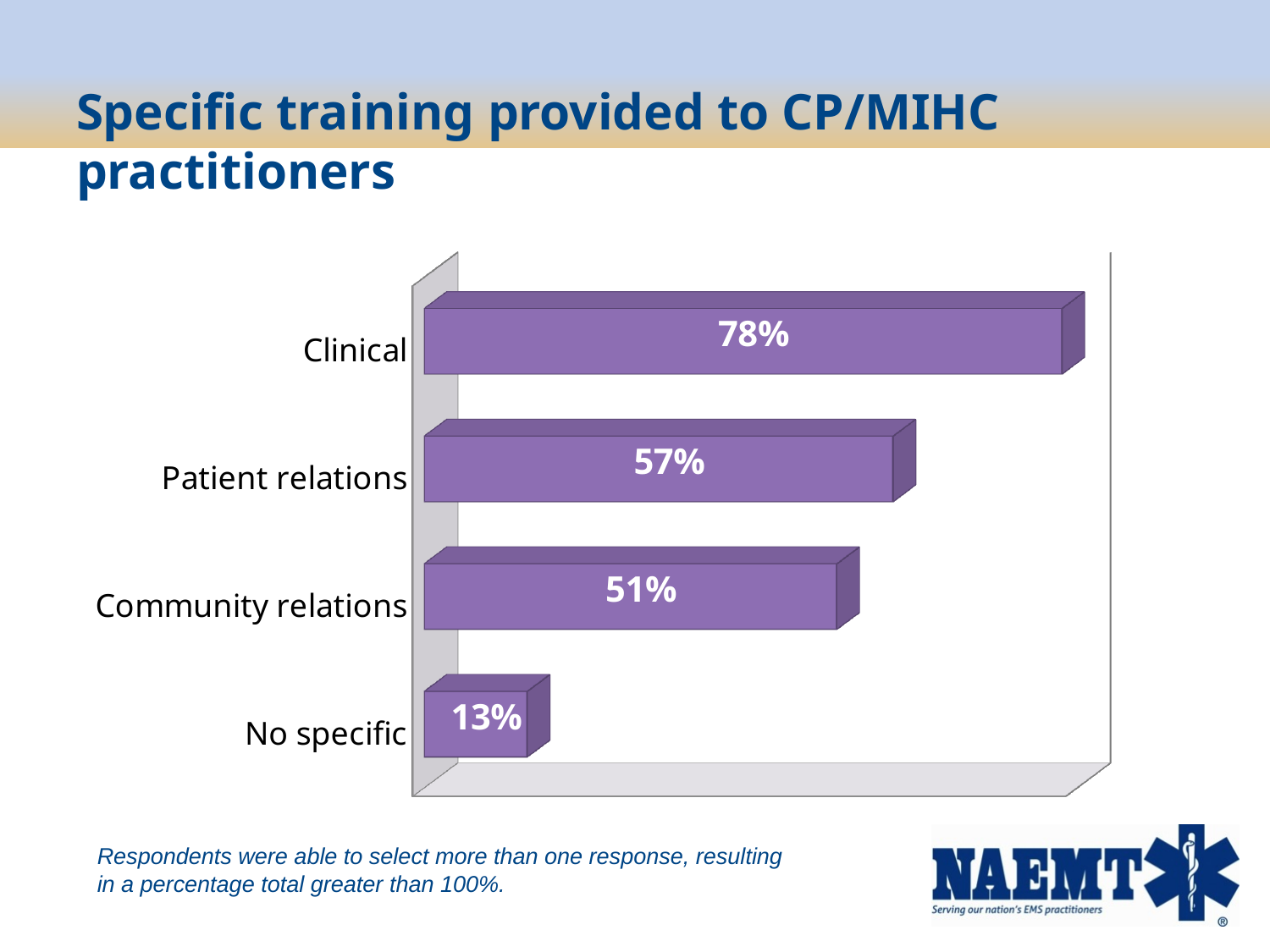
What is the difference in percentage points between Clinical and Patient relations? 21 What is the difference in percentage points between Patient relations and Community relations? 6 What colour are the bars in the chart? Purple Which category has the lowest percentage? No specific What is the value shown for Patient relations? 57% What is the value shown for No specific training? 13% Which training category has the highest percentage? Clinical What is the value shown for Community relations? 51% How many training categories are shown in the chart? 4 What percentage of respondents reported providing clinical training to CP/MIHC practitioners? 78% What type of chart is shown on the slide? Bar chart Which is larger, the value for Community relations or the value for No specific? Community relations